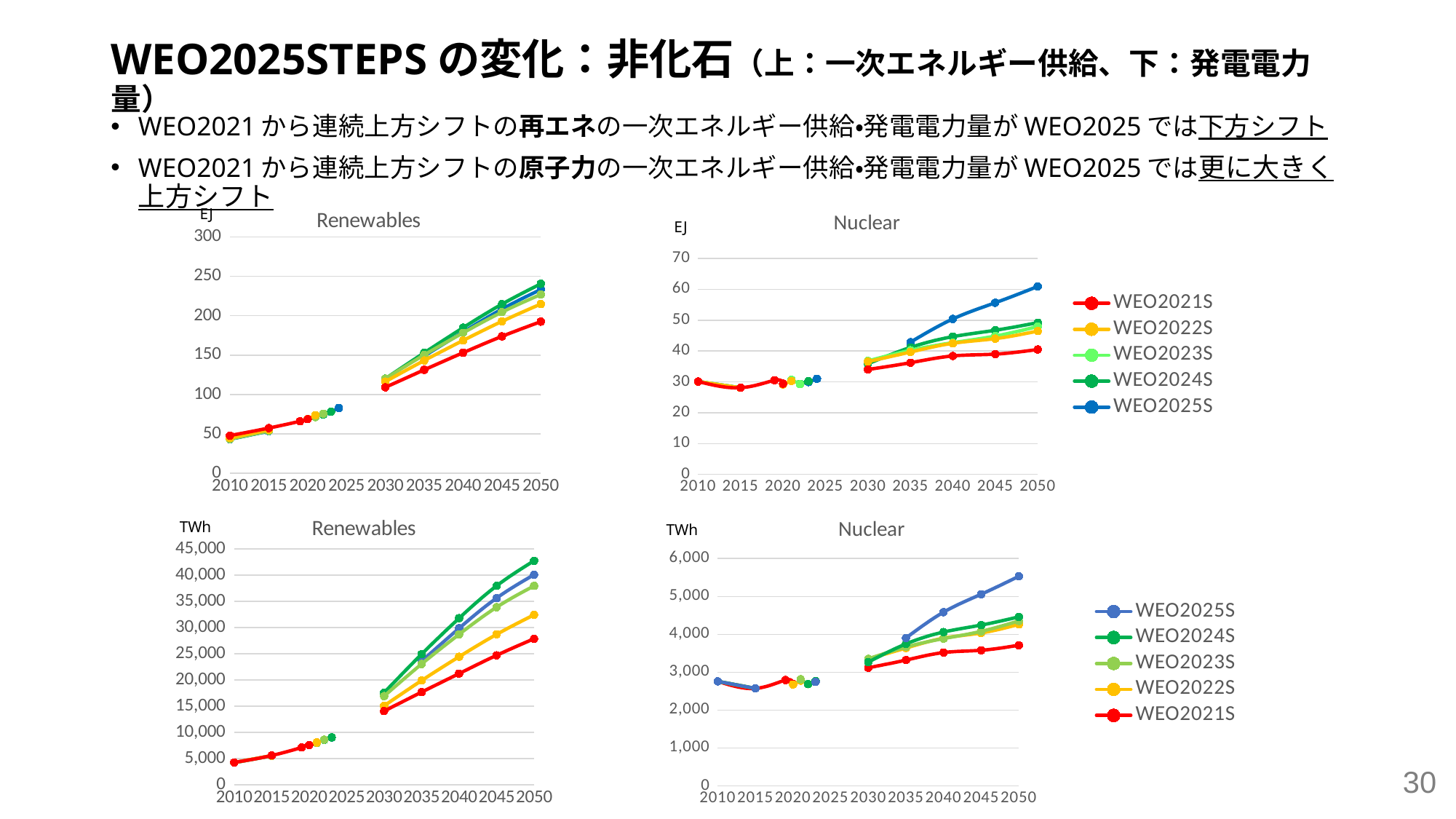
In the top-left Renewables chart, is the value for WEO2021S in 2050 greater or less than 200? less What kind of chart is the top-left chart titled Renewables? line chart In the bottom-right Nuclear chart, do the values for WEO2025S rise or fall from 2030 to 2050? rise In the top-right Nuclear chart, how many series does the legend list? 5 In the bottom-right Nuclear chart, is the value for WEO2021S in 2050 greater or less than 4,000? less In the top-right Nuclear chart, which is larger in 2050, WEO2025S or WEO2021S? WEO2025S In the top-right Nuclear chart, is the value for WEO2025S in 2050 greater or less than 50? greater What unit is shown on the y axis of the bottom-left Renewables chart? TWh In the bottom-right Nuclear chart, which series has the highest value in 2050? WEO2025S How many year labels are shown on the x axis of the top-left Renewables chart? 9 In the bottom-left Renewables chart, which series has the lowest value in 2050? WEO2021S